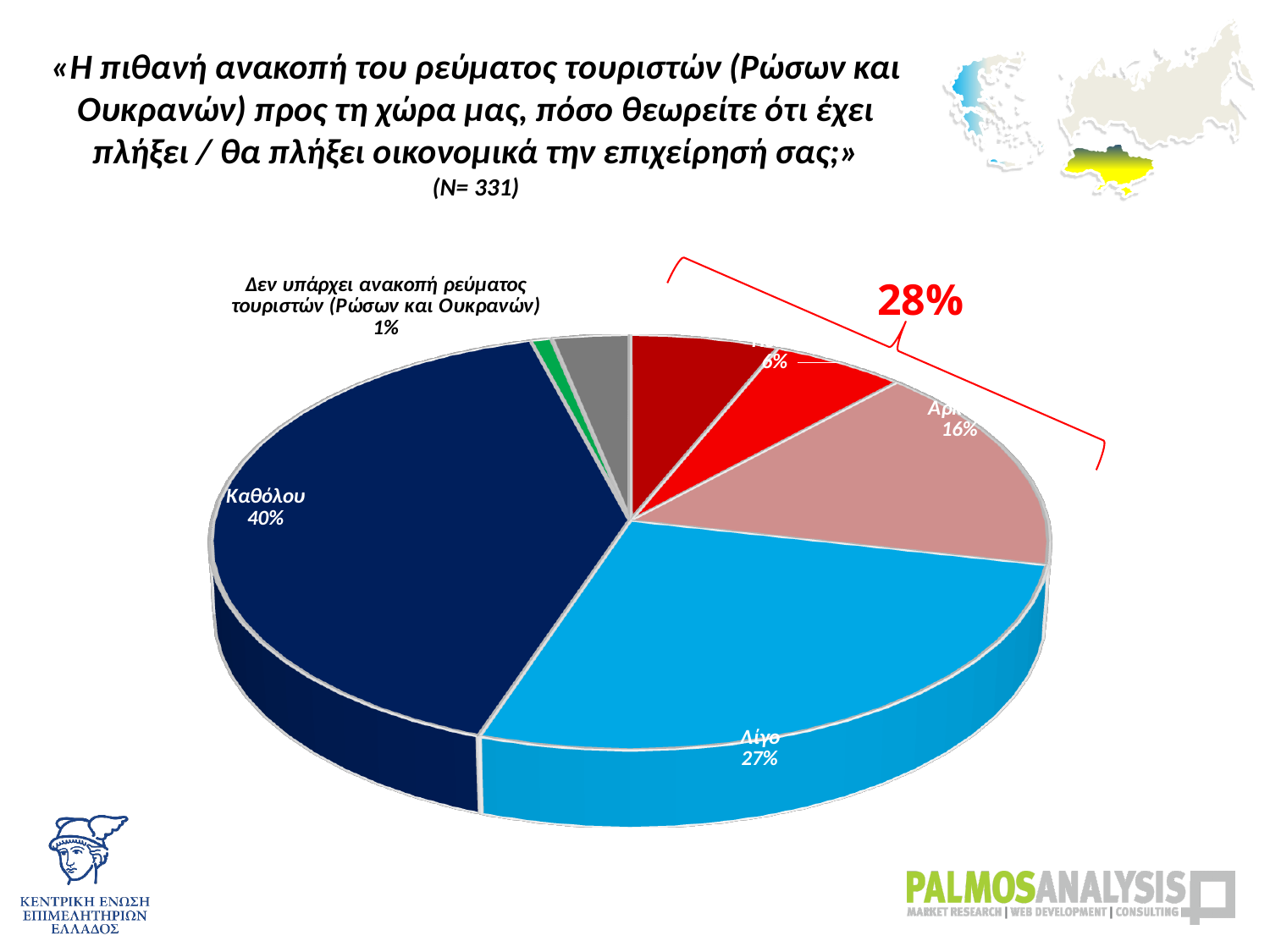
What percentage of respondents answered "Καθόλου"? 40% What is the sample size (N) stated under the chart title? 331 How many slices does the pie chart have? 7 What combined percentage is indicated by the red bracket above the pie? 28% What share of the pie is labelled "Δεν υπάρχει ανακοπή ρεύματος τουριστών (Ρώσων και Ουκρανών)"? 1% By how many percentage points does "Καθόλου" exceed "Λίγο"? 13 percentage points What kind of chart is shown on the slide? pie chart Which response category has the largest slice of the pie? Καθόλου What percentage of respondents answered "Λίγο"? 27% Which slice is larger, "Καθόλου" or "Λίγο"? Καθόλου